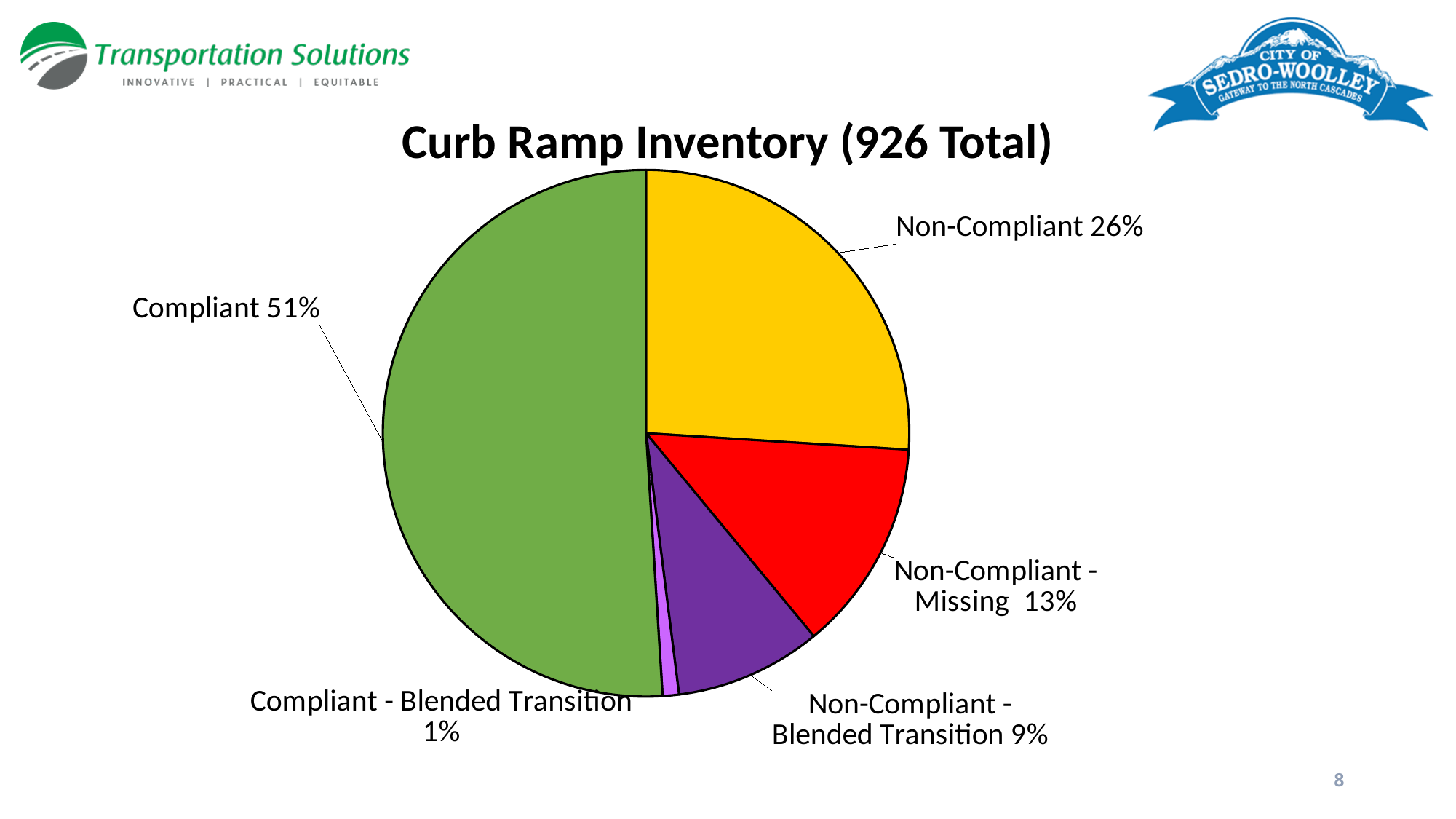
What percentage of curb ramps are Compliant? 51% What percentage of curb ramps are Compliant - Blended Transition? 1% How many slices does the pie chart have? 5 Which category has the largest share of the pie? Compliant What percentage of curb ramps are Non-Compliant - Blended Transition? 9% Which category has the smallest share of the pie? Compliant - Blended Transition What percentage of curb ramps are Non-Compliant - Missing? 13% Which is larger, the Non-Compliant - Missing share or the Non-Compliant - Blended Transition share? Non-Compliant - Missing What kind of chart is shown on the slide? Pie chart What is the difference in percentage points between Non-Compliant and Non-Compliant - Missing? 13 What is the title of the chart? Curb Ramp Inventory (926 Total) What percentage of curb ramps are Non-Compliant? 26%